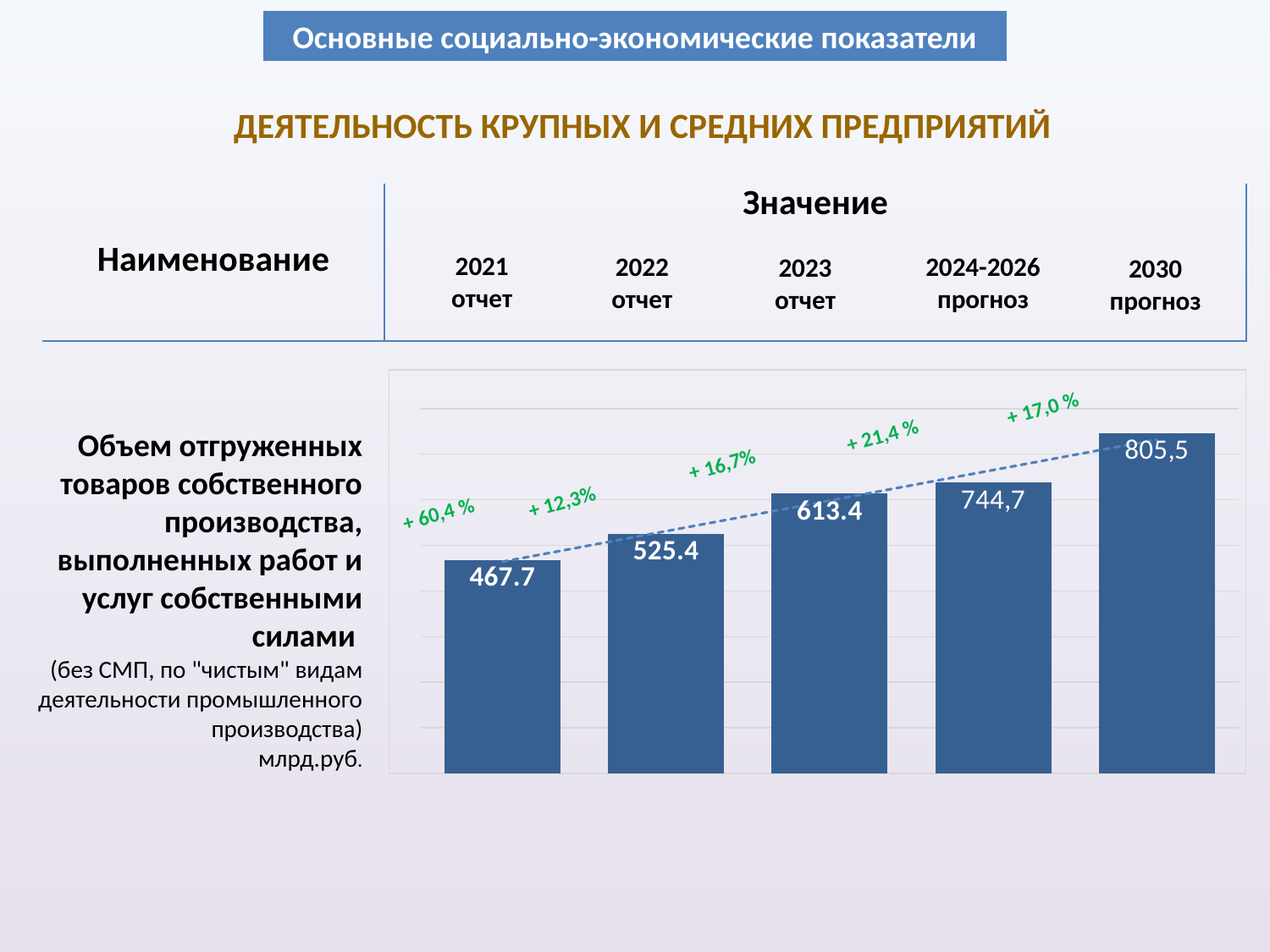
What is the difference between the values for 2022 отчет and 2021 отчет? 57.7 Which period has the highest bar? 2030 прогноз What is the value of the bar for 2023 отчет? 613.4 Do the bar values rise or fall from 2021 to 2030? Rise What is the value of the bar for 2030 прогноз? 805,5 Which is larger, the value for 2023 отчет or the value for 2022 отчет? 2023 отчет What is the value of the bar for 2021 отчет? 467.7 What is the value of the bar for 2024-2026 прогноз? 744,7 What is the difference between the values for 2030 прогноз and 2024-2026 прогноз? 60,8 Which period has the lowest bar? 2021 отчет How many bars are shown in the chart? 5 What kind of chart is shown on the slide? Bar chart